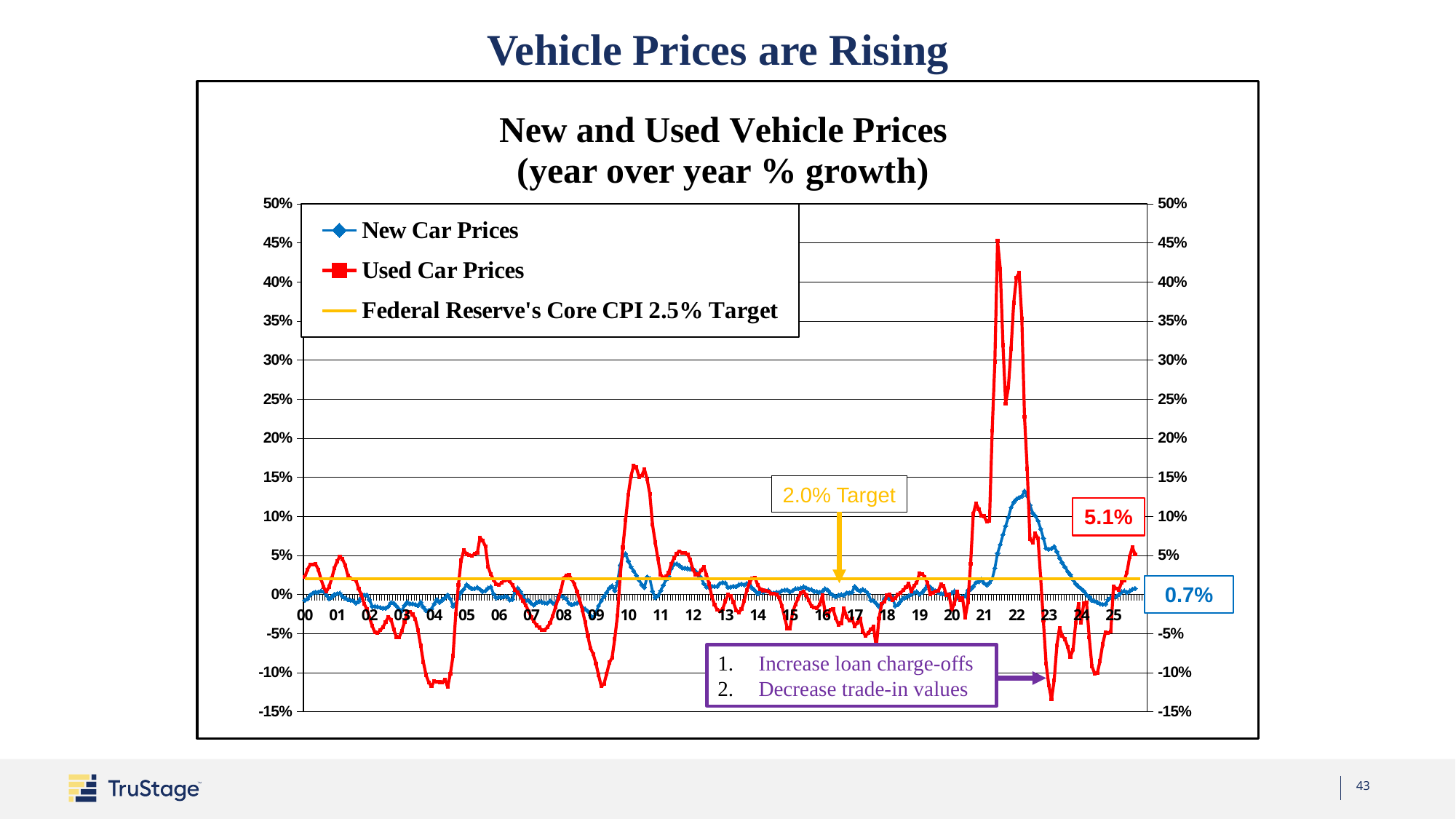
Which is larger at the end of the series, the latest Used Car Prices value or the latest New Car Prices value? Used Car Prices What is the latest labelled value for Used Car Prices? 5.1% What is the title of the chart? New and Used Vehicle Prices (year over year % growth) Which series reaches the highest peak on the chart? Used Car Prices What is the latest labelled value for New Car Prices? 0.7% How many series does the legend list? 3 What is the difference between the latest labelled Used Car Prices value (5.1%) and the latest labelled New Car Prices value (0.7%)? 4.4 percentage points Is the peak value for Used Car Prices in 2021 greater or less than 40%? greater What kind of chart is shown on the slide? line chart Is the lowest value for Used Car Prices around 2023 greater or less than -10%? less Is the peak value for New Car Prices around 2022 greater or less than 10%? greater Did Used Car Prices rise or fall between 2023 and 2025? rise